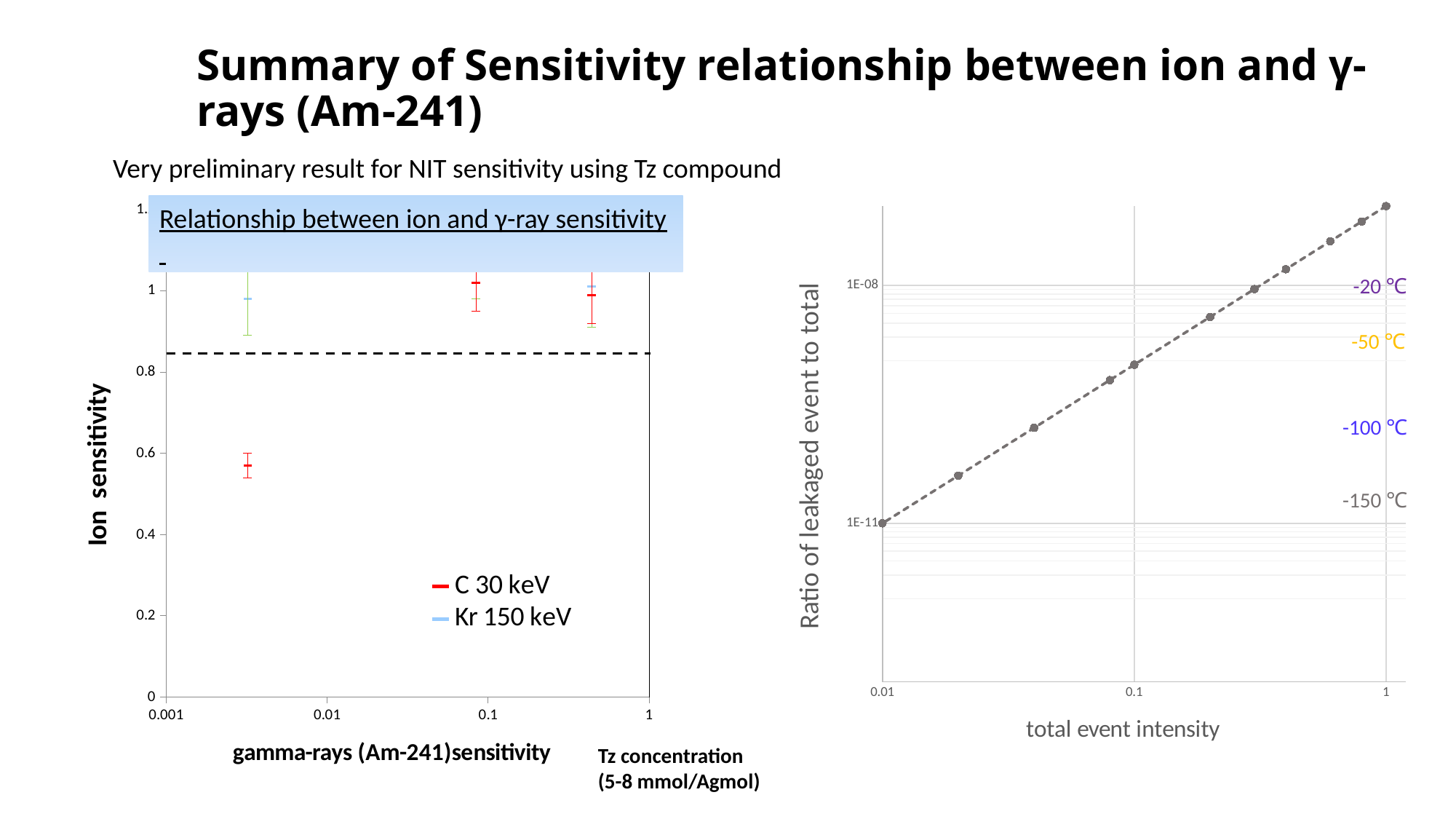
What kind of chart is the left chart titled 'Relationship between ion and γ-ray sensitivity'? Scatter chart What are the two series named in the legend of the left chart? C 30 keV and Kr 150 keV In the left chart, which series has the point with the lowest ion sensitivity? C 30 keV What is the y-axis label of the right chart? Ratio of leakaged event to total How many series does the legend of the left chart list? 2 In the right chart, what is the ratio of leakaged event to total at a total event intensity of 0.01? 1E-11 In the right chart, does the ratio of leakaged event to total rise or fall as total event intensity increases? Rises In the left chart, is the ion sensitivity of the C 30 keV point near a gamma-ray sensitivity of 0.003 greater or less than 0.6? less In the left chart, which C 30 keV point has the higher ion sensitivity: the one near gamma-ray sensitivity 0.003 or the one near 0.08? The one near 0.08 In the left chart, is the ion sensitivity of the C 30 keV point near a gamma-ray sensitivity of 0.003 greater or less than 0.4? greater In the right chart, is the ratio of leakaged event to total at a total event intensity of 0.1 greater or less than 1E-08? less What is the x-axis label of the left chart? gamma-rays (Am-241)sensitivity